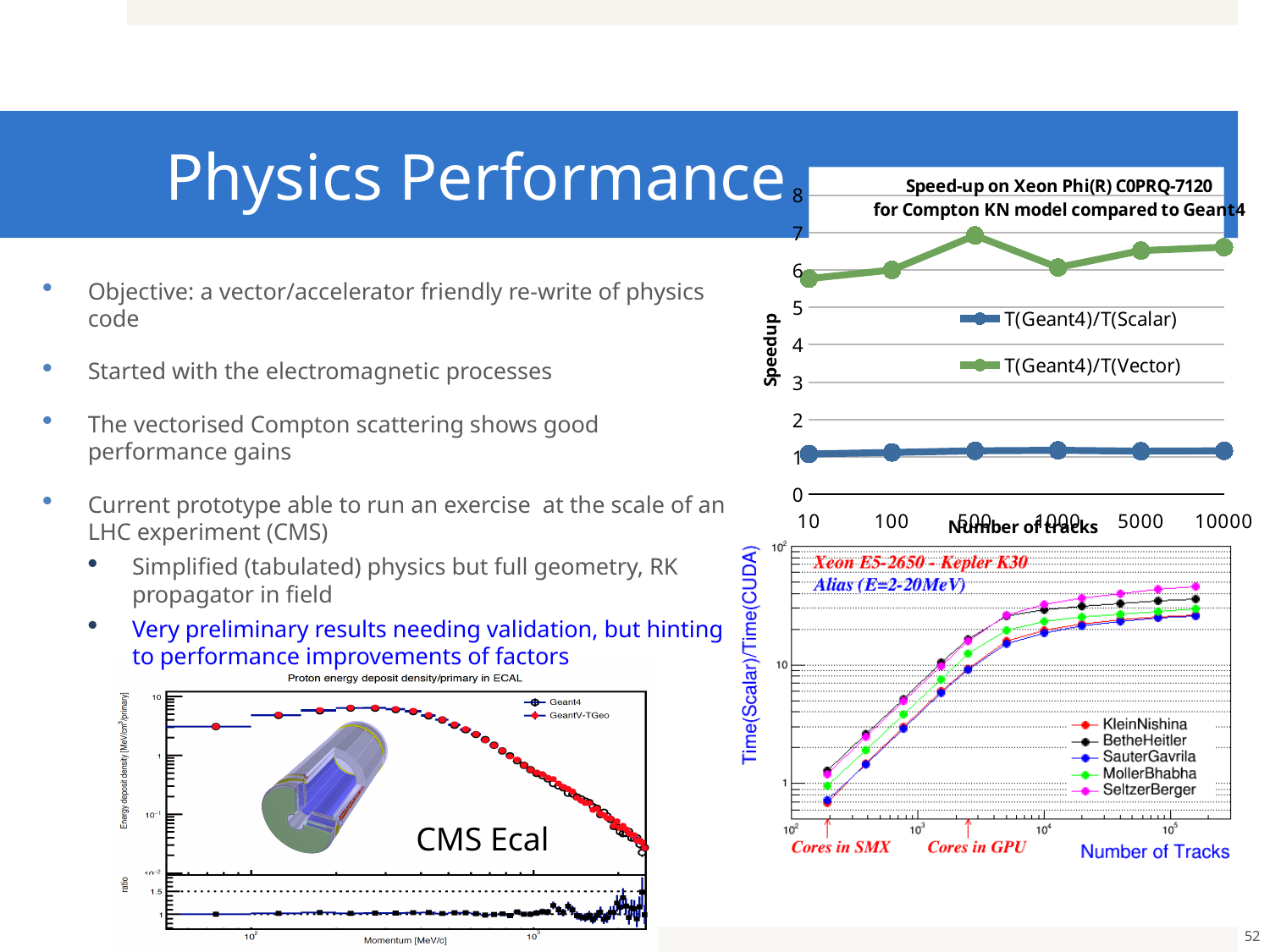
In the top-right chart titled "Speed-up on Xeon Phi(R) C0PRQ-7120 for Compton KN model compared to Geant4", how many series does the legend list? 2 In the top-right speed-up chart, at which number of tracks does T(Geant4)/T(Vector) reach its highest value? 500 In the bottom-right chart with y axis Time(Scalar)/Time(CUDA), how many series does the legend list? 5 In the top-right speed-up chart, which series has the larger value at 1000 tracks, T(Geant4)/T(Scalar) or T(Geant4)/T(Vector)? T(Geant4)/T(Vector) In the top-right speed-up chart, is the value of T(Geant4)/T(Scalar) at 10000 tracks greater or less than 2? less What kind of chart is the top-right speed-up chart? Line chart In the top-right speed-up chart, is the value of T(Geant4)/T(Vector) at 5000 tracks greater or less than 5? greater In the top-right speed-up chart, what is the label on the y axis? Speedup In the top-right speed-up chart, what are the two series named in the legend? T(Geant4)/T(Scalar) and T(Geant4)/T(Vector) In the top-right speed-up chart, is the value of T(Geant4)/T(Vector) at 500 tracks greater or less than 6? greater In the top-right speed-up chart, how many points are plotted along the x axis for each series? 6 In the bottom-left chart titled "Proton energy deposit density/primary in ECAL", how many series does the legend list? 2